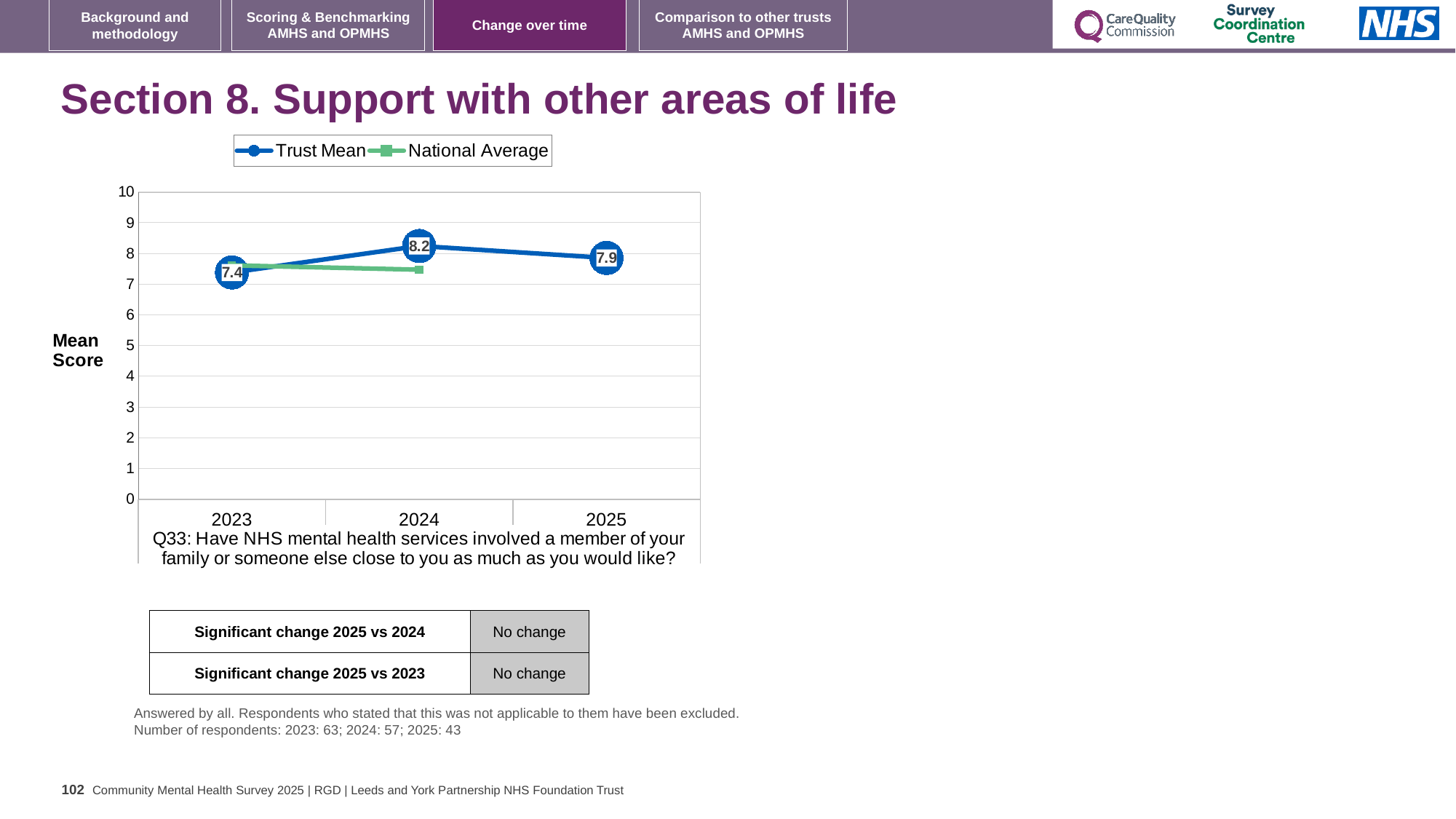
How many years are shown on the x axis? 3 What kind of chart is shown on the slide? line chart What is the difference between the Trust Mean in 2024 and in 2023? 0.8 Which is larger, the Trust Mean for 2025 or for 2023? 2025 What is the Trust Mean score for 2023? 7.4 What is the Trust Mean score for 2025? 7.9 Is the National Average value for 2024 greater or less than 8? less In which year is the Trust Mean lowest? 2023 How many series does the legend list? 2 What is the difference between the Trust Mean in 2024 and in 2025? 0.3 What is the Trust Mean score for 2024? 8.2 In which year is the Trust Mean highest? 2024